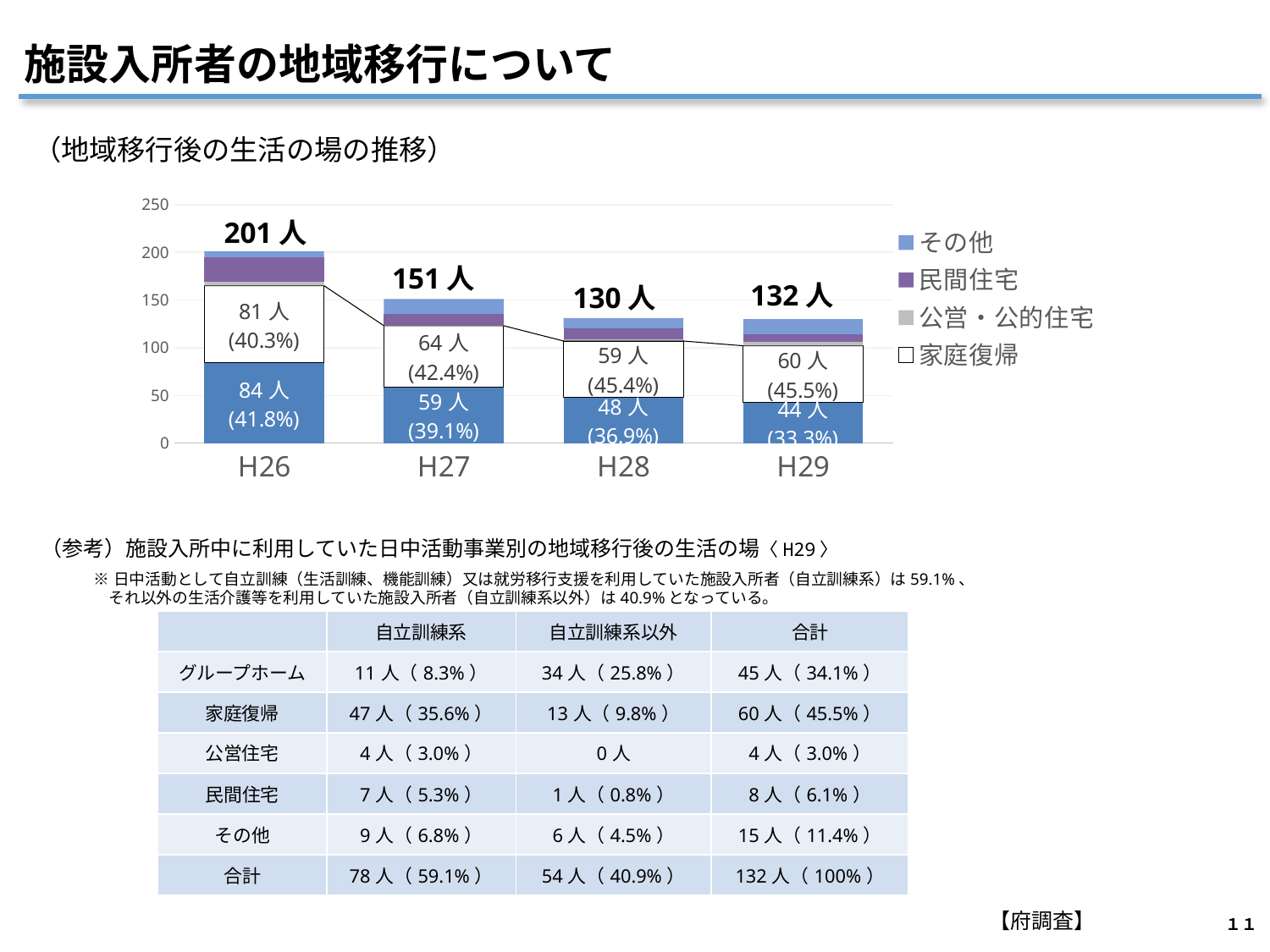
What is the value of 家庭復帰 for H27? 64人 How many years (categories) are shown on the x axis of the chart? 4 Is the total for H28 greater or less than 150? less What kind of chart is shown on the slide? stacked bar chart Which is larger, the 家庭復帰 value for H28 or for H29? H29 Which year has the lowest total number of people? H28 What is the total number of people shown above the H26 bar? 201人 What percentage is shown for 家庭復帰 in H29? 45.5% Which year has the highest total number of people? H26 What is the difference between the total for H26 and the total for H27? 50人 Does the percentage for 家庭復帰 rise or fall from H26 to H29? rise How many series does the chart legend list? 4